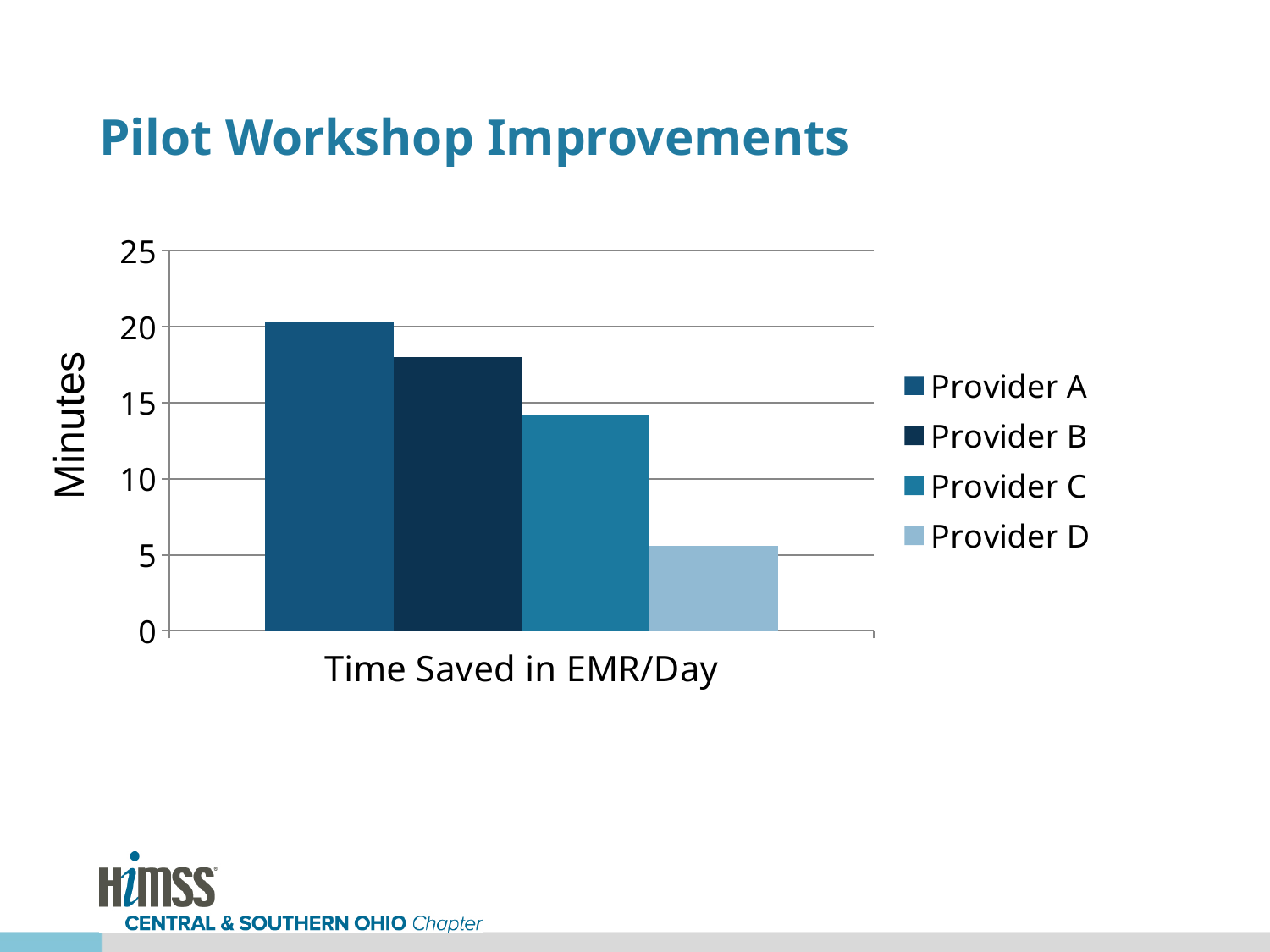
Which is larger, the value for Provider C or the value for Provider D? Provider C Is the value for Provider C greater or less than 15? less Is the value for Provider D greater or less than 10? less How many series does the legend list? 4 Is the value for Provider A greater or less than 15? greater What is the label on the vertical axis of the chart? Minutes Which provider has the lowest time saved in EMR/Day? Provider D What is the title of the slide containing the chart? Pilot Workshop Improvements Which is larger, the value for Provider B or the value for Provider C? Provider B Which provider has the highest time saved in EMR/Day? Provider A What kind of chart is shown on the slide? bar chart